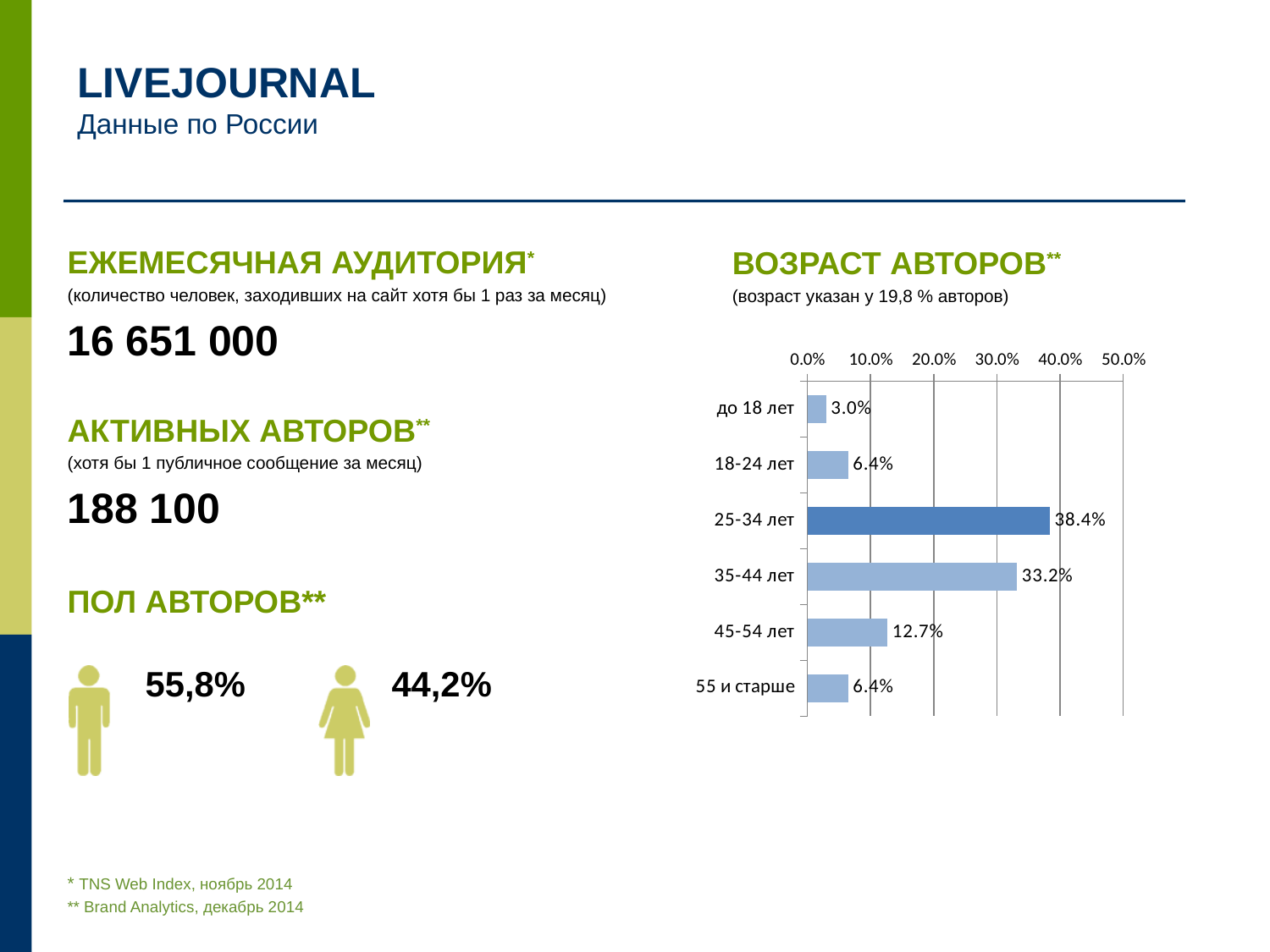
How many age categories are shown in the ВОЗРАСТ АВТОРОВ chart? 6 Which is larger in the ВОЗРАСТ АВТОРОВ chart: the value for 45-54 лет or the value for 18-24 лет? 45-54 лет What type of chart is the ВОЗРАСТ АВТОРОВ chart? bar chart What is the value for the 55 и старше category in the ВОЗРАСТ АВТОРОВ chart? 6.4% What is the value for the 45-54 лет category in the ВОЗРАСТ АВТОРОВ chart? 12.7% What is the highest tick value shown on the axis of the ВОЗРАСТ АВТОРОВ chart? 50.0% Which age category has the lowest value in the ВОЗРАСТ АВТОРОВ chart? до 18 лет What is the difference between the 25-34 лет and 35-44 лет values in the ВОЗРАСТ АВТОРОВ chart? 5.2% Which age category has the highest value in the ВОЗРАСТ АВТОРОВ chart? 25-34 лет What is the value for the до 18 лет category in the ВОЗРАСТ АВТОРОВ chart? 3.0% Is the value for 35-44 лет in the ВОЗРАСТ АВТОРОВ chart greater or less than 30.0%? greater What is the value for the 25-34 лет category in the ВОЗРАСТ АВТОРОВ chart? 38.4%